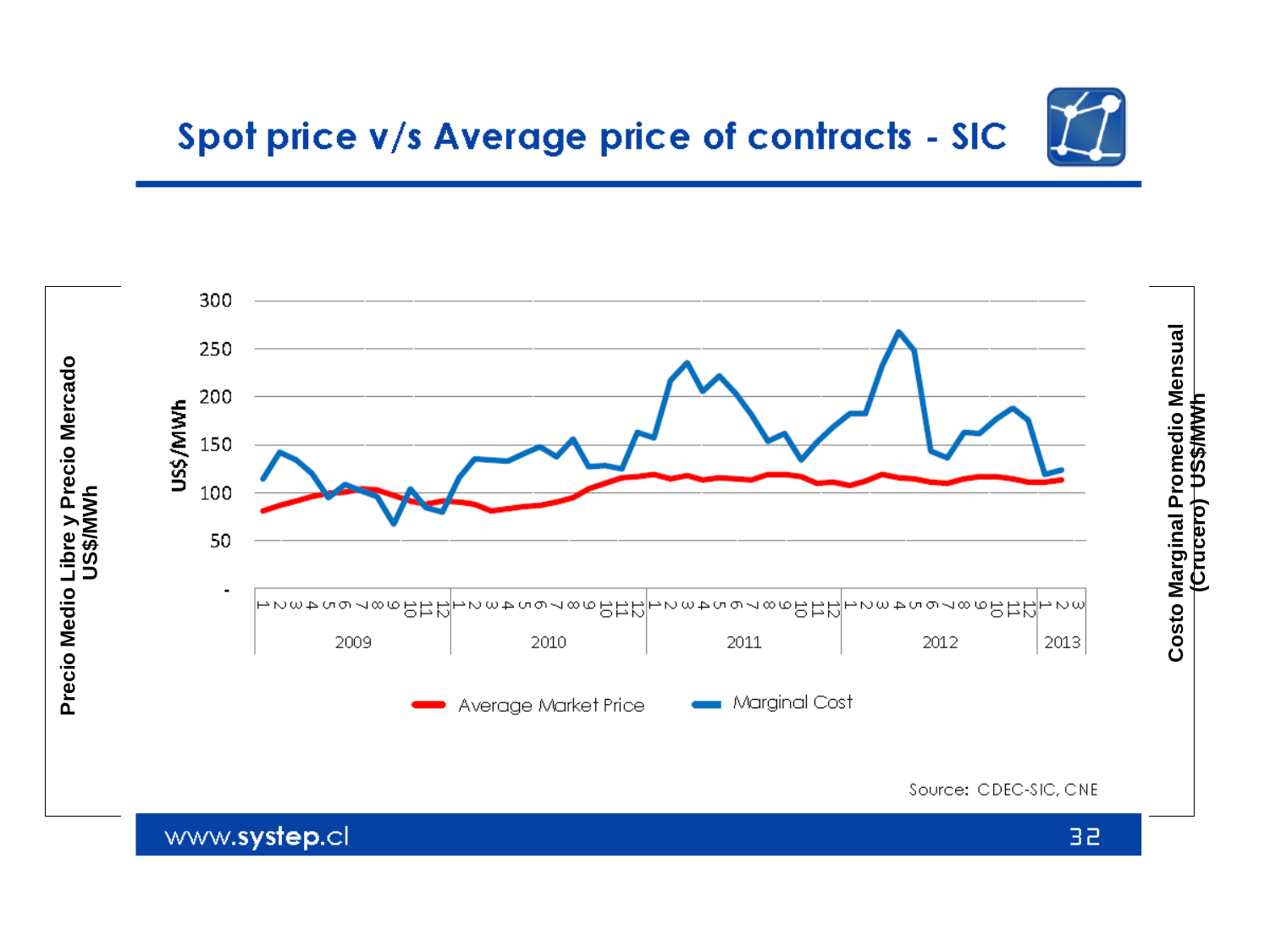
How many months of 2013 are plotted on the x axis? 3 In month 9 of 2009, which series has the larger value, Average Market Price or Marginal Cost? Average Market Price Is the Marginal Cost value in month 9 of 2009 greater or less than 100? less What colour is the Marginal Cost line in the legend? Blue Is the Marginal Cost value in month 4 of 2012 greater or less than 250? greater How many series does the legend list? 2 What kind of chart is shown on the slide? Line chart In which year does the Marginal Cost series reach its highest peak? 2012 How many years are labelled along the x axis? 5 Is the Average Market Price in month 3 of 2010 greater or less than 100? less In month 4 of 2012, which series has the larger value, Average Market Price or Marginal Cost? Marginal Cost